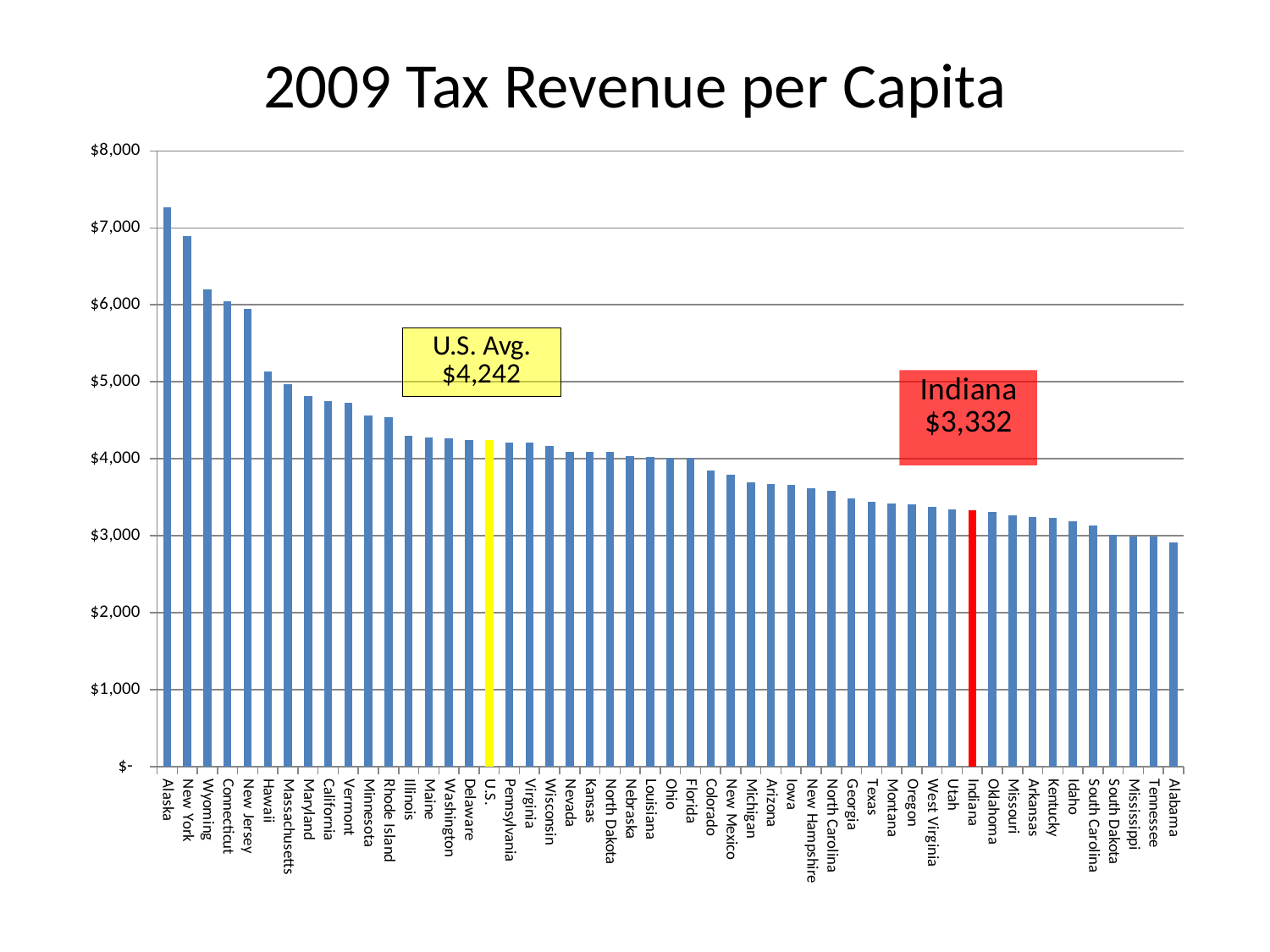
What kind of chart is shown on the slide? bar chart Is the value for Alaska greater or less than $7,000? greater How much lower is Indiana's tax revenue per capita than the U.S. average? $910 What colour is the bar for Indiana? red What is the U.S. average tax revenue per capita shown on the chart? $4,242 Which has the higher tax revenue per capita, Alaska or New York? Alaska Is the value for Hawaii greater or less than $5,000? greater Which state has the highest tax revenue per capita? Alaska What is the 2009 tax revenue per capita for Indiana? $3,332 Do the values rise or fall moving from left to right along the x axis? fall Which state has the lowest tax revenue per capita? Alabama Is the value for Colorado greater or less than $4,000? less